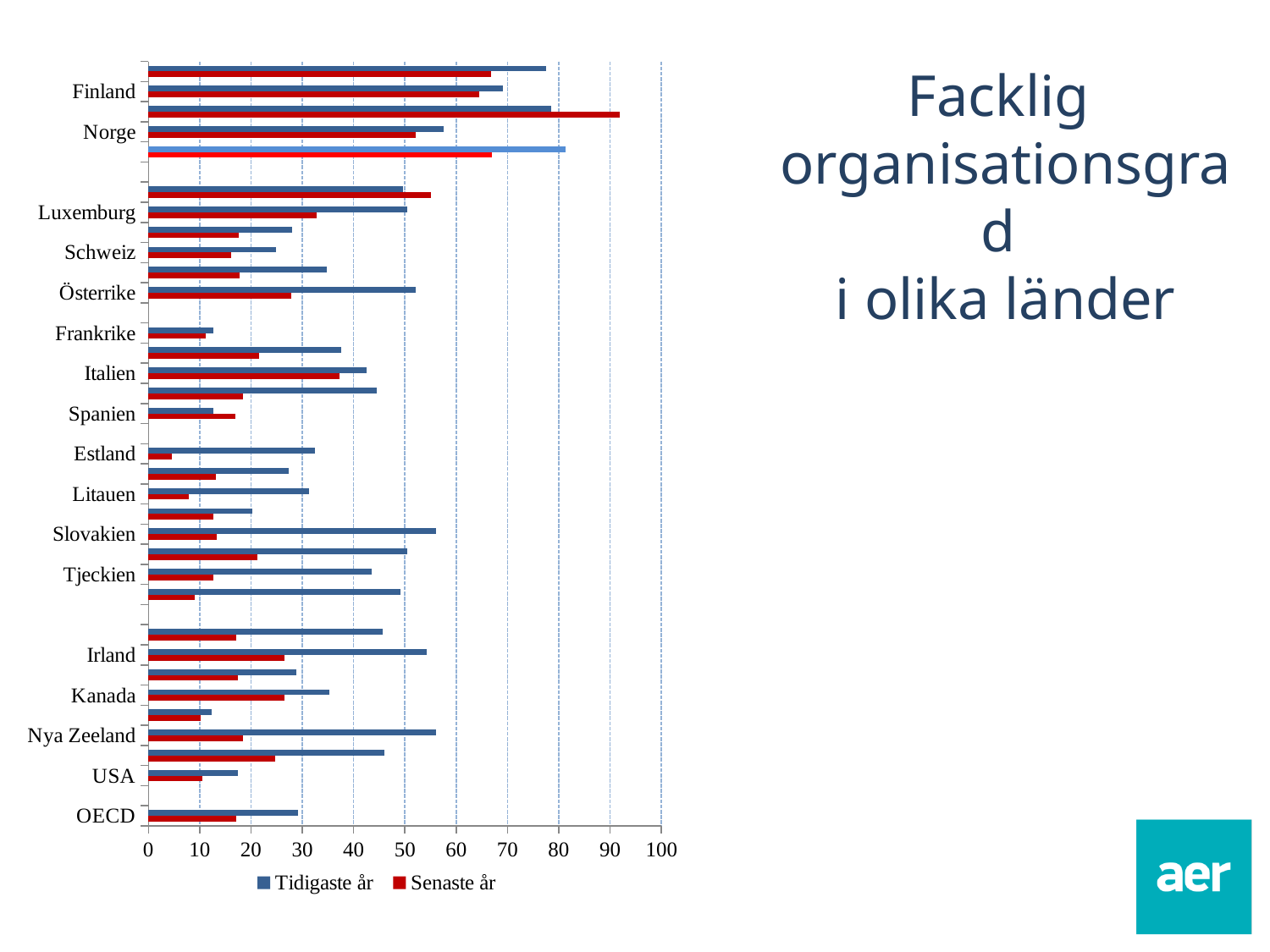
Is the 'Tidigaste år' value for Frankrike greater or less than 20? less Is the 'Tidigaste år' value for Slovakien greater or less than 50? greater Is the 'Tidigaste år' value for Luxemburg greater or less than 40? greater Which colour represents the series 'Senaste år'? Red What kind of chart is shown on the slide? Bar chart For Estland, which series has the larger value, 'Tidigaste år' or 'Senaste år'? Tidigaste år What are the two series named in the legend? Tidigaste år and Senaste år How many series does the legend list? 2 For Slovakien, which series has the larger value, 'Tidigaste år' or 'Senaste år'? Tidigaste år